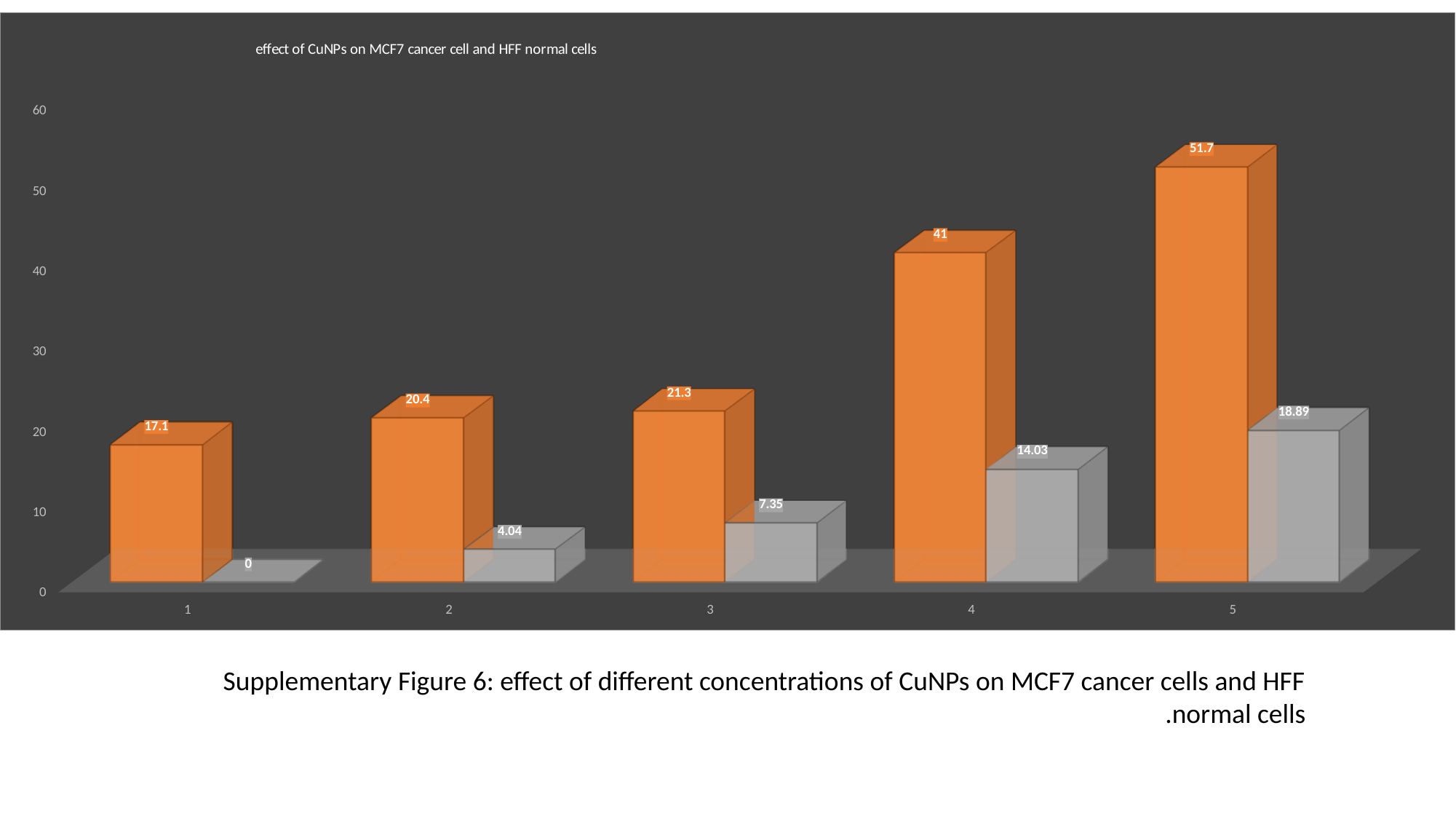
What is the difference between the orange and grey bars for category 3? 13.95 Which category has the lowest grey bar? 1 What is the value of the grey bar for category 4? 14.03 What is the difference between the orange bars for category 5 and category 4? 10.7 Which category has the highest orange bar? 5 How many categories are shown on the x axis? 5 Which is larger, the grey bar for category 5 or the orange bar for category 1? grey bar for category 5 Do the grey bar values rise or fall from category 1 to category 5? rise What kind of chart is shown on the slide? bar chart What is the value of the orange bar for category 2? 20.4 What is the value of the orange bar for category 5? 51.7 What is the value of the grey bar for category 1? 0